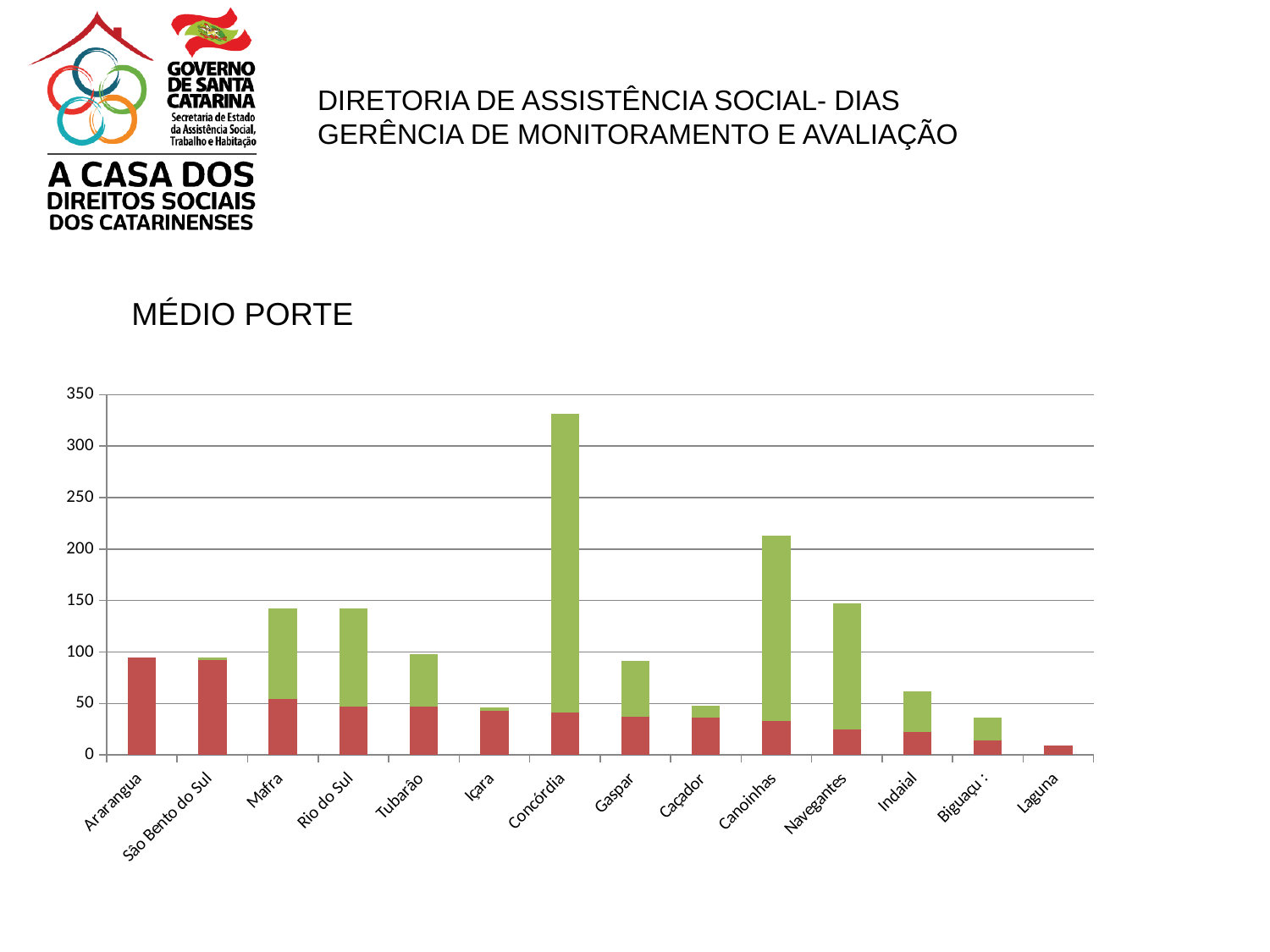
Is the total value for Gaspar greater or less than 100? less Which category has the highest total bar in the chart? Concórdia Is the total value for Indaial greater or less than 50? greater Which category has the lowest total bar in the chart? Laguna What is the title shown above the chart? MÉDIO PORTE Is the total value for Laguna greater or less than 50? less Which has a larger total bar, Araranguá or Laguna? Araranguá What kind of chart is shown on the slide? bar chart Which has a larger total bar, Concórdia or Canoinhas? Concórdia How many categories (municipalities) are shown on the x axis of the chart? 14